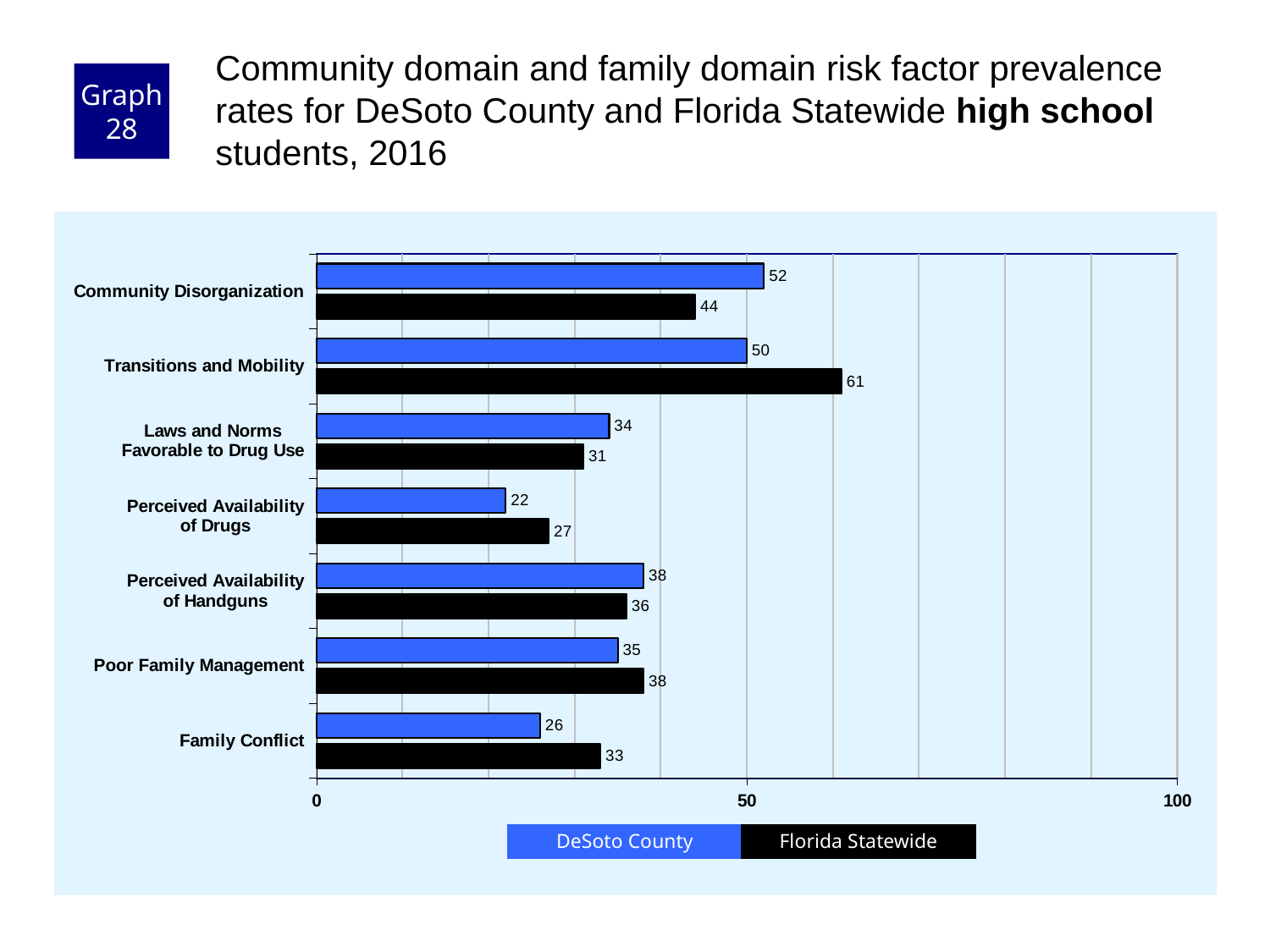
How many series does the legend list? 2 Is the DeSoto County value for Community Disorganization greater or less than 50? greater What is the DeSoto County value for Community Disorganization? 52 What is the DeSoto County value for Perceived Availability of Drugs? 22 Which colour represents Florida Statewide in the chart? Black Which risk factor has the lowest DeSoto County value? Perceived Availability of Drugs Which risk factor has the highest Florida Statewide value? Transitions and Mobility What is the Florida Statewide value for Transitions and Mobility? 61 For Family Conflict, which is larger: the DeSoto County value or the Florida Statewide value? Florida Statewide How many risk factor categories are shown on the chart? 7 What is the difference between the Florida Statewide and DeSoto County values for Transitions and Mobility? 11 What kind of chart is shown on the slide? Bar chart